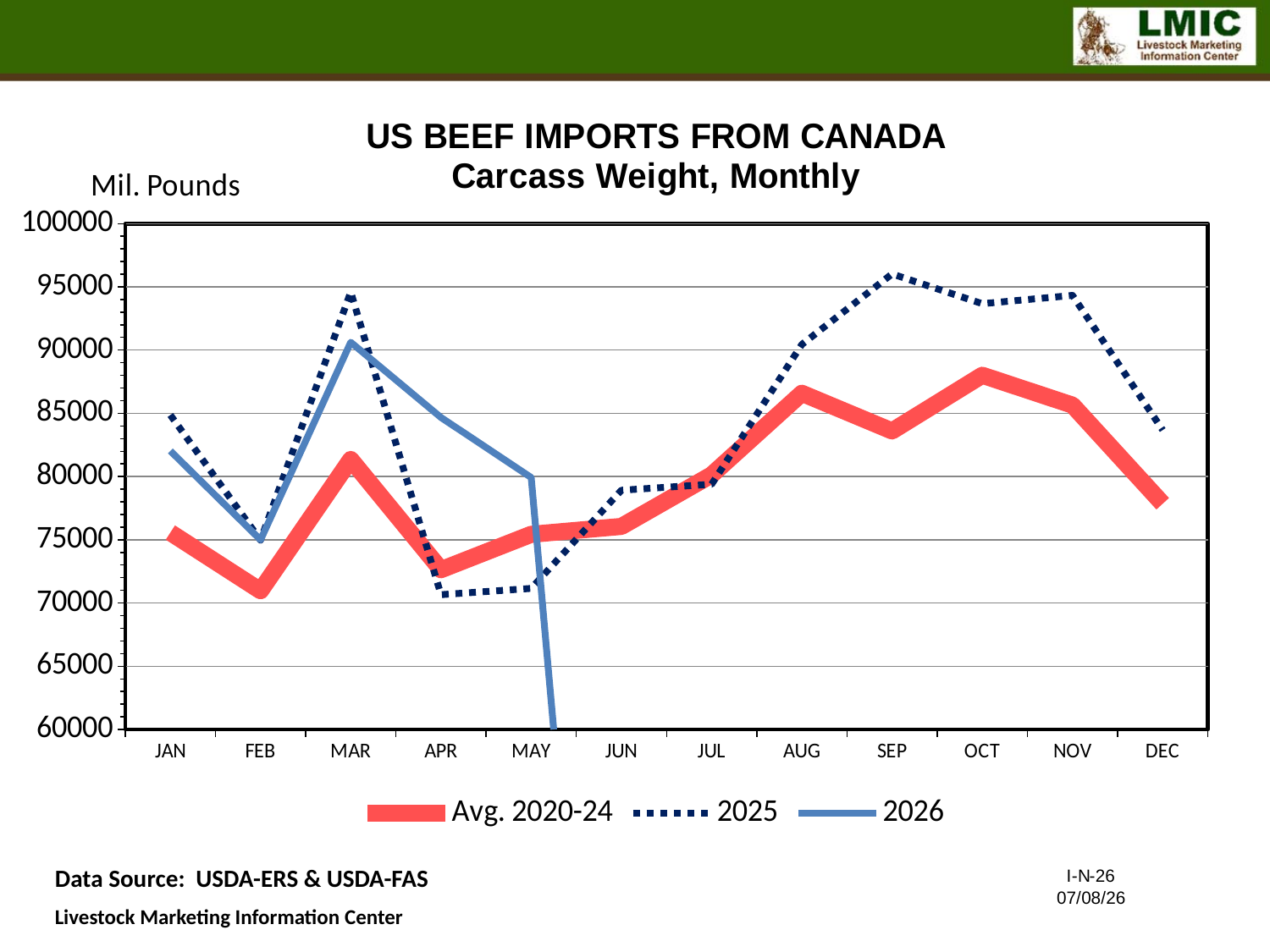
In which month does the 2025 series reach its lowest value? APR Is the value for Avg. 2020-24 in FEB greater or less than 75000? less What unit is shown on the y axis label? Mil. Pounds How many series does the legend list? 3 In which month does the 2025 series reach its highest value? SEP In which month is the Avg. 2020-24 series at its highest? OCT Is the value for 2025 in MAR greater or less than 90000? greater In which month is the Avg. 2020-24 series at its lowest? FEB What kind of chart is shown on the slide? Line chart In APR, which series has the larger value, 2026 or 2025? 2026 Does the 2025 series rise or fall from APR to SEP? Rise How many months are shown on the x axis? 12